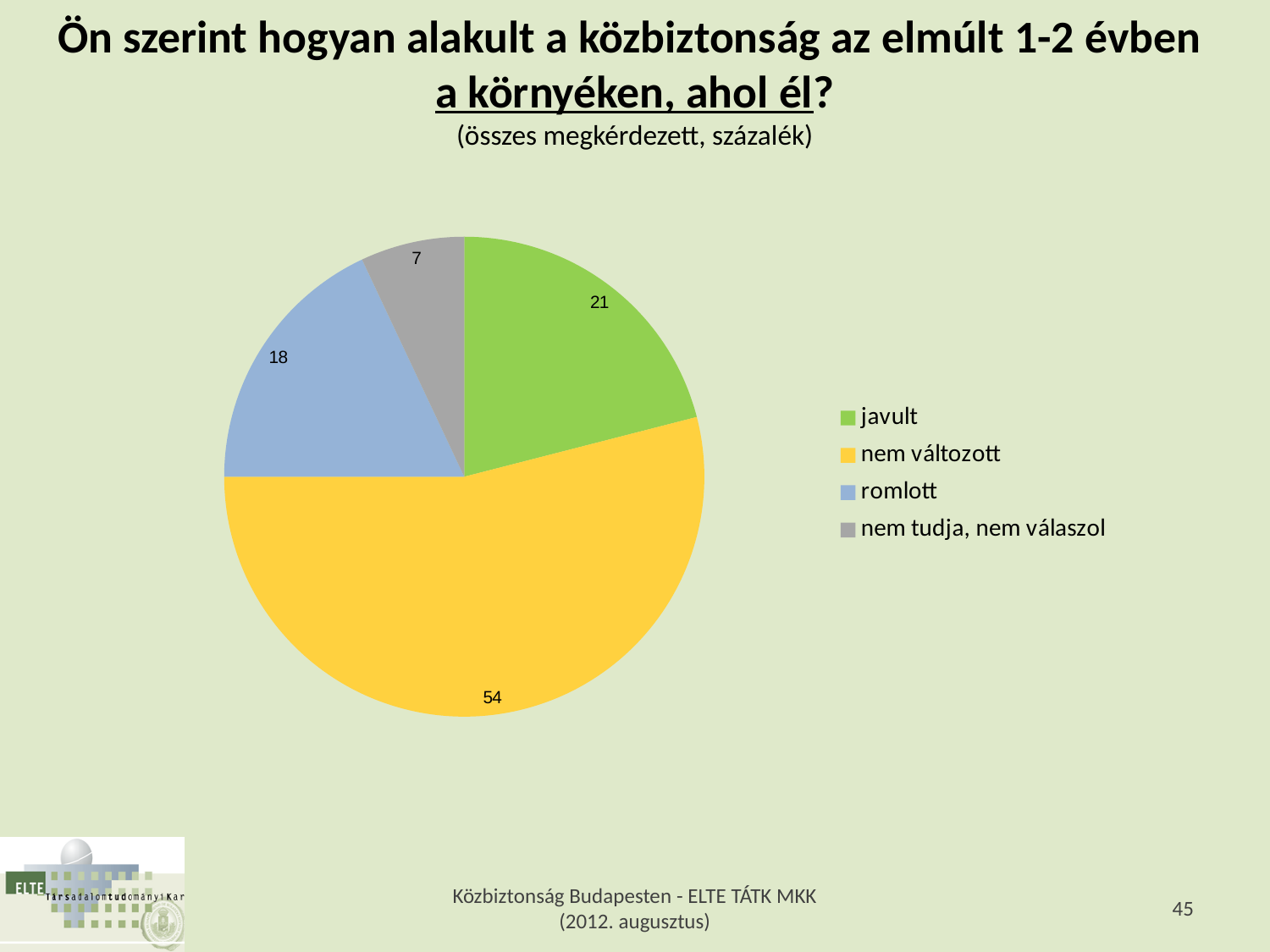
What is the difference between the values for "nem változott" and "javult"? 33 Which category has the largest slice? nem változott What is the value for "nem tudja, nem válaszol"? 7 What is the difference between the values for "romlott" and "nem tudja, nem válaszol"? 11 How many categories does the pie chart have? 4 What kind of chart is shown on the slide? pie chart What is the value for "romlott"? 18 Which colour represents "romlott" in the legend? blue Which category has the smallest slice? nem tudja, nem válaszol What is the value for "javult"? 21 What is the value for "nem változott"? 54 Which is larger, the value for "javult" or the value for "romlott"? javult